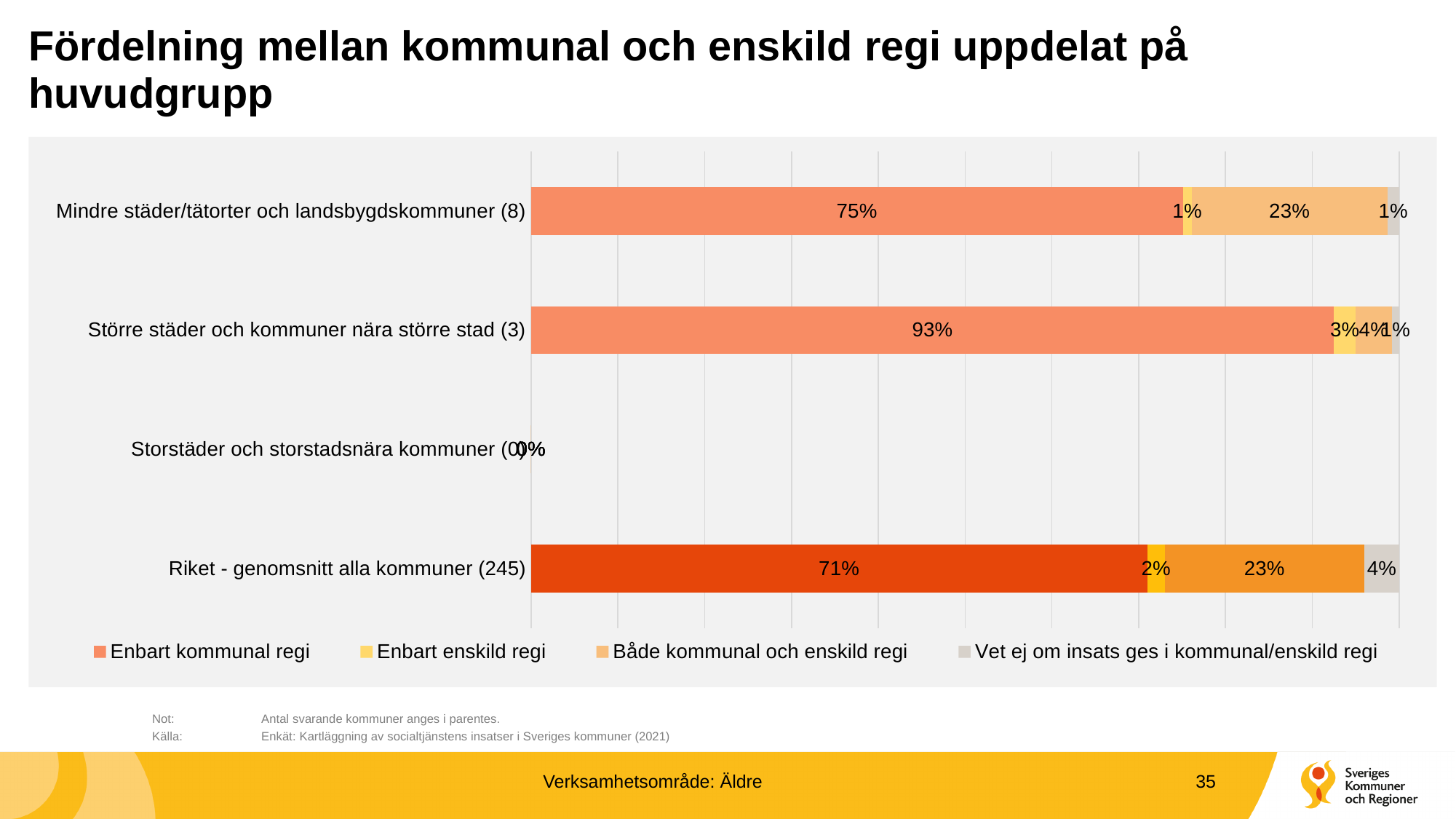
Which is larger: the 'Både kommunal och enskild regi' value for 'Mindre städer/tätorter och landsbygdskommuner (8)' or for 'Större städer och kommuner nära större stad (3)'? Mindre städer/tätorter och landsbygdskommuner (8) What is the difference between the 'Enbart kommunal regi' values for 'Större städer och kommuner nära större stad (3)' and 'Riket - genomsnitt alla kommuner (245)'? 22% What is the value of 'Enbart kommunal regi' for 'Mindre städer/tätorter och landsbygdskommuner (8)'? 75% What is the value of 'Vet ej om insats ges i kommunal/enskild regi' for 'Riket - genomsnitt alla kommuner (245)'? 4% How many series does the legend list? 4 How many categories are shown on the y axis? 4 Which legend entry is shown in grey? Vet ej om insats ges i kommunal/enskild regi What is the value of 'Enbart kommunal regi' for 'Större städer och kommuner nära större stad (3)'? 93% Which category has the highest value for 'Enbart kommunal regi'? Större städer och kommuner nära större stad (3) What is the value of 'Enbart enskild regi' for 'Riket - genomsnitt alla kommuner (245)'? 2% What kind of chart is shown on the slide? bar chart What is the value of 'Både kommunal och enskild regi' for 'Riket - genomsnitt alla kommuner (245)'? 23%